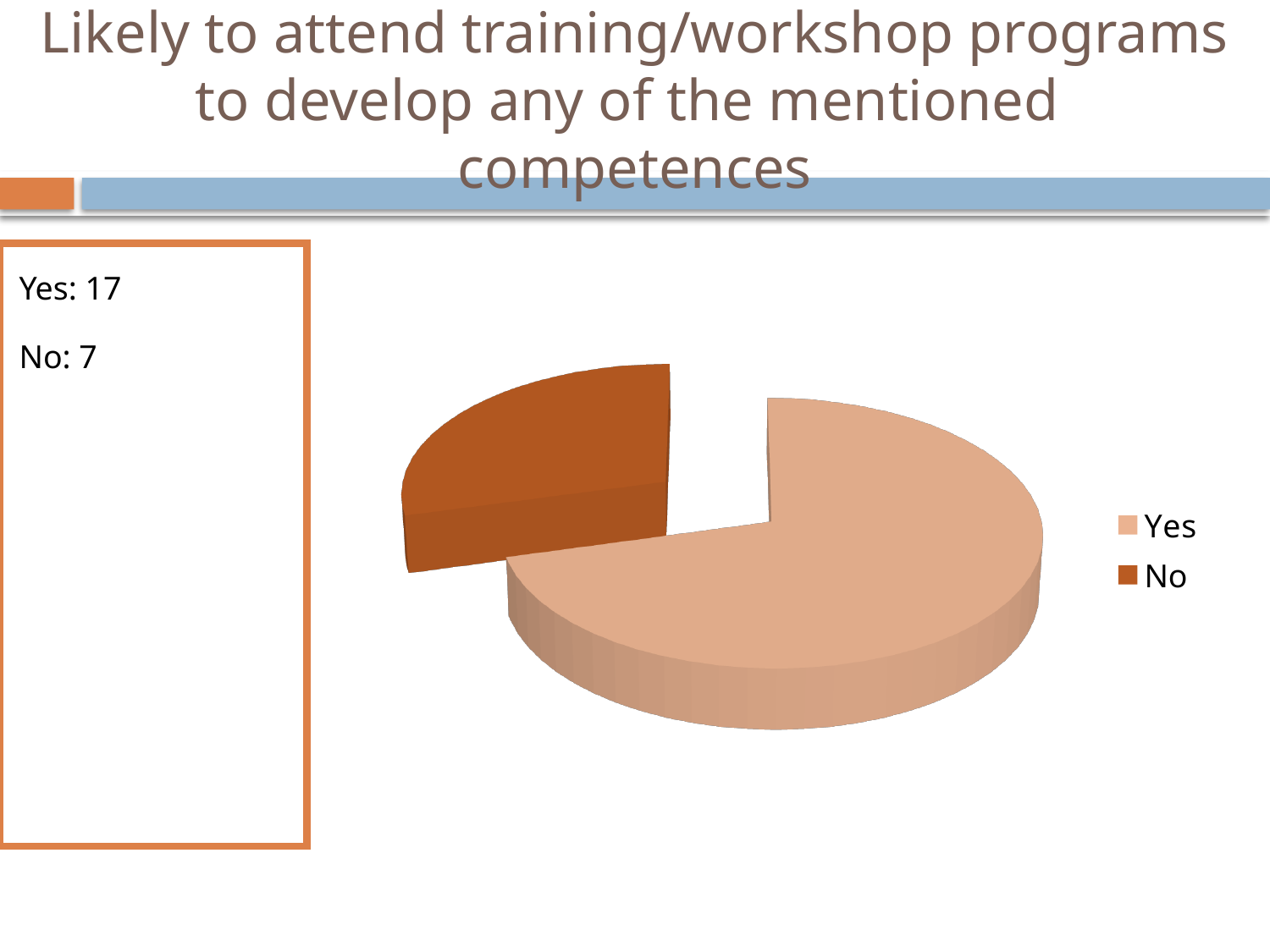
Which category has the largest slice of the pie? Yes Which legend entry is shown in the darker orange-brown colour? No Which is larger, the value for Yes or the value for No? Yes How many entries does the legend of the pie chart list? 2 What is the value for No? 7 What type of chart is shown on the slide? Pie chart What is the difference between the Yes and No values? 10 What is the title of the slide containing the pie chart? Likely to attend training/workshop programs to develop any of the mentioned competences What is the total of the Yes and No values? 24 How many slices does the pie chart have? 2 Which category has the smallest slice of the pie? No What is the value for Yes? 17